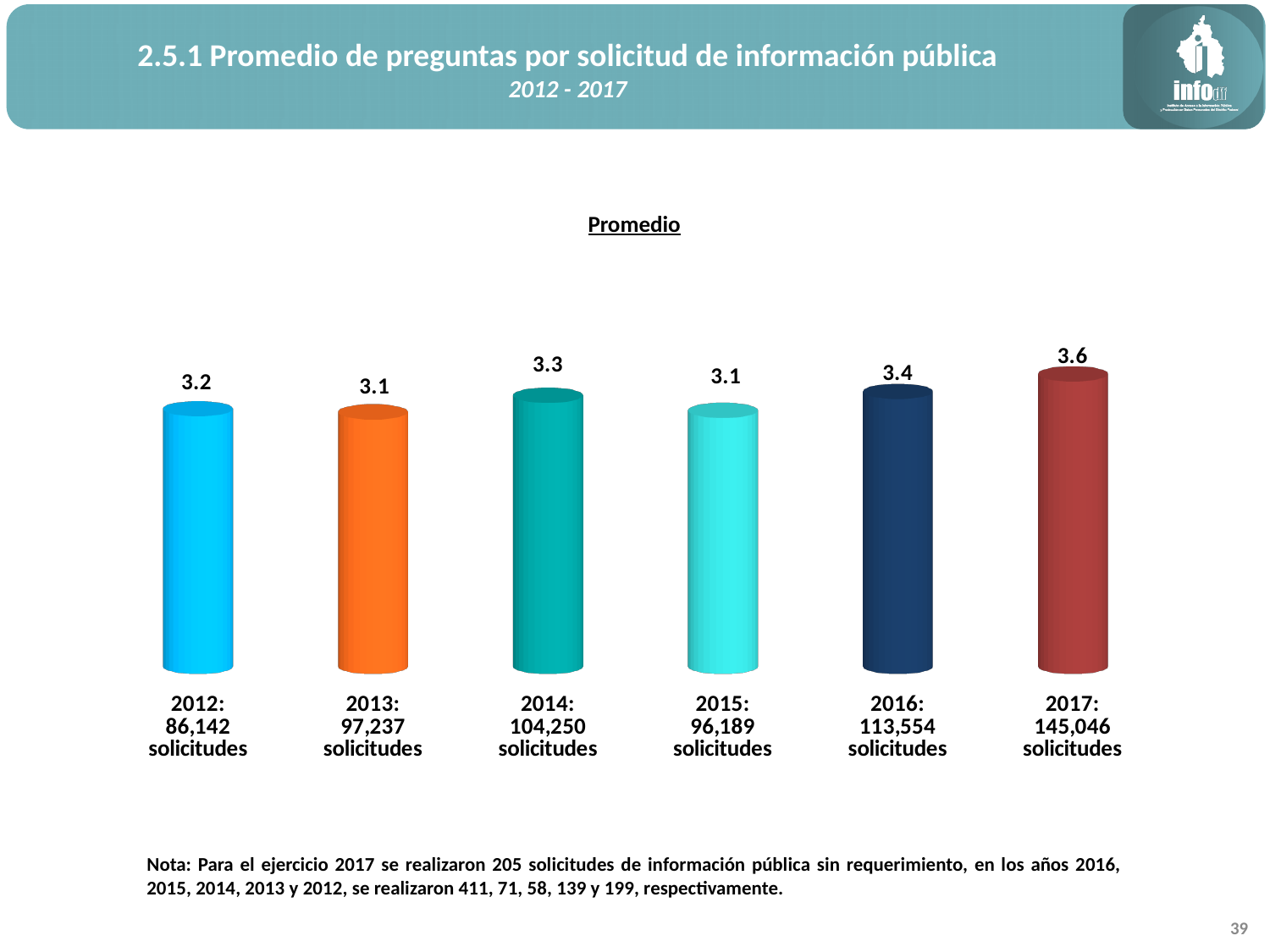
What is the lowest Promedio value shown on the chart? 3.1 What is the title shown above the chart? Promedio How many years (bars) are shown on the chart? 6 What is the Promedio value shown for 2016? 3.4 What is the average number of questions per request (Promedio) for 2012? 3.2 How many solicitudes are listed under the 2017 bar label? 145,046 solicitudes Which year has the larger Promedio value, 2014 or 2015? 2014 Which year has the highest Promedio value? 2017 Does the Promedio value rise or fall from 2015 to 2017? Rise What is the Promedio value shown for 2017? 3.6 What is the difference between the Promedio values for 2017 and 2012? 0.4 What kind of chart is shown on the slide? Bar chart